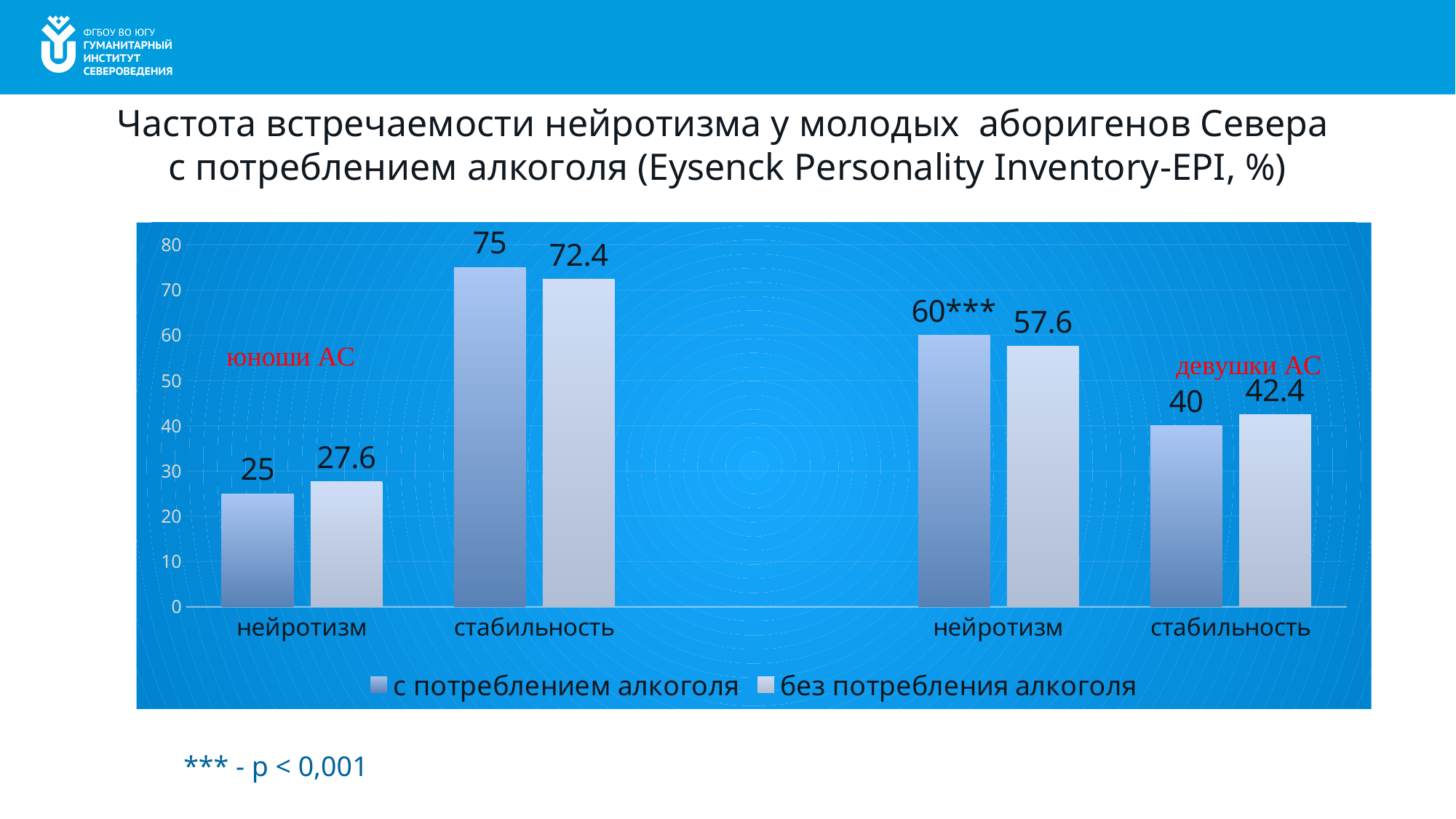
Which bar has the lowest value on the chart? нейротизм, юноши АС, с потреблением алкоголя (25) What is the difference between the two series for стабильность among девушки АС? 2.4 Which data label on the chart is marked with three asterisks (***)? 60 (нейротизм, девушки АС, с потреблением алкоголя) For нейротизм among девушки АС, which series has the larger value: 'с потреблением алкоголя' or 'без потребления алкоголя'? с потреблением алкоголя What is the value for нейротизм among юноши АС in the series 'с потреблением алкоголя'? 25 Which bar has the highest value on the chart? стабильность, юноши АС, с потреблением алкоголя (75) What is the value for нейротизм among девушки АС in the series 'без потребления алкоголя'? 57.6 What kind of chart is shown on the slide? bar chart What is the value for стабильность among юноши АС in the series 'без потребления алкоголя'? 72.4 How many bars are plotted on the chart in total? 8 How many series does the legend list? 2 What is the value for стабильность among девушки АС in the series 'с потреблением алкоголя'? 40